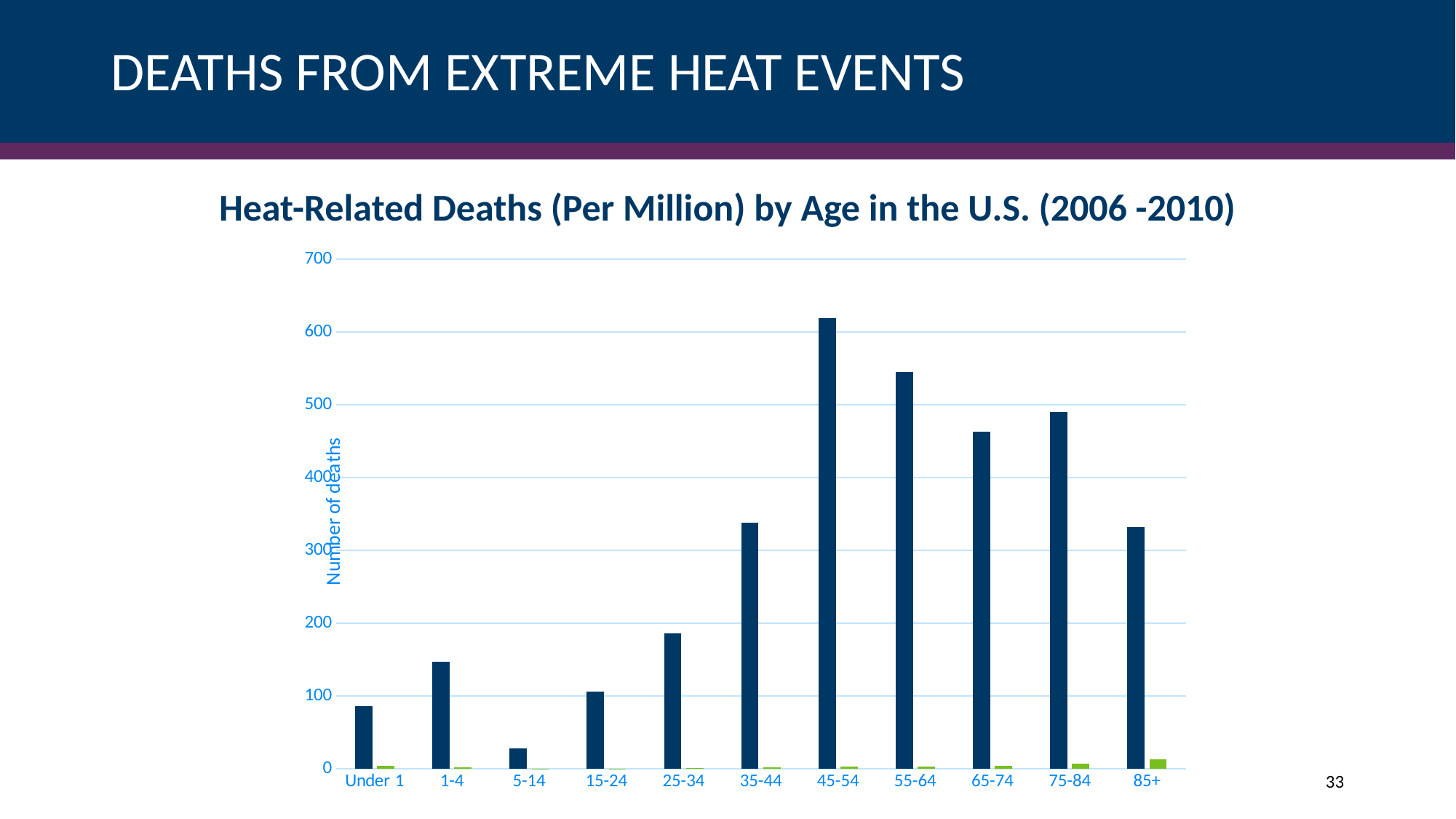
Is the dark blue value for 25-34 greater or less than 200? less Is the dark blue value for 35-44 greater or less than 300? greater What is the title of the chart? Heat-Related Deaths (Per Million) by Age in the U.S. (2006 -2010) Which has a larger dark blue value, 1-4 or Under 1? 1-4 Which has a larger dark blue value, 55-64 or 65-74? 55-64 How many age categories are shown on the x axis? 11 Which age group has the highest dark blue bar? 45-54 Is the dark blue value for 5-14 greater or less than 100? less Which age group has the lowest dark blue bar? 5-14 What kind of chart is shown on the slide? bar chart What is the label on the vertical axis? Number of deaths